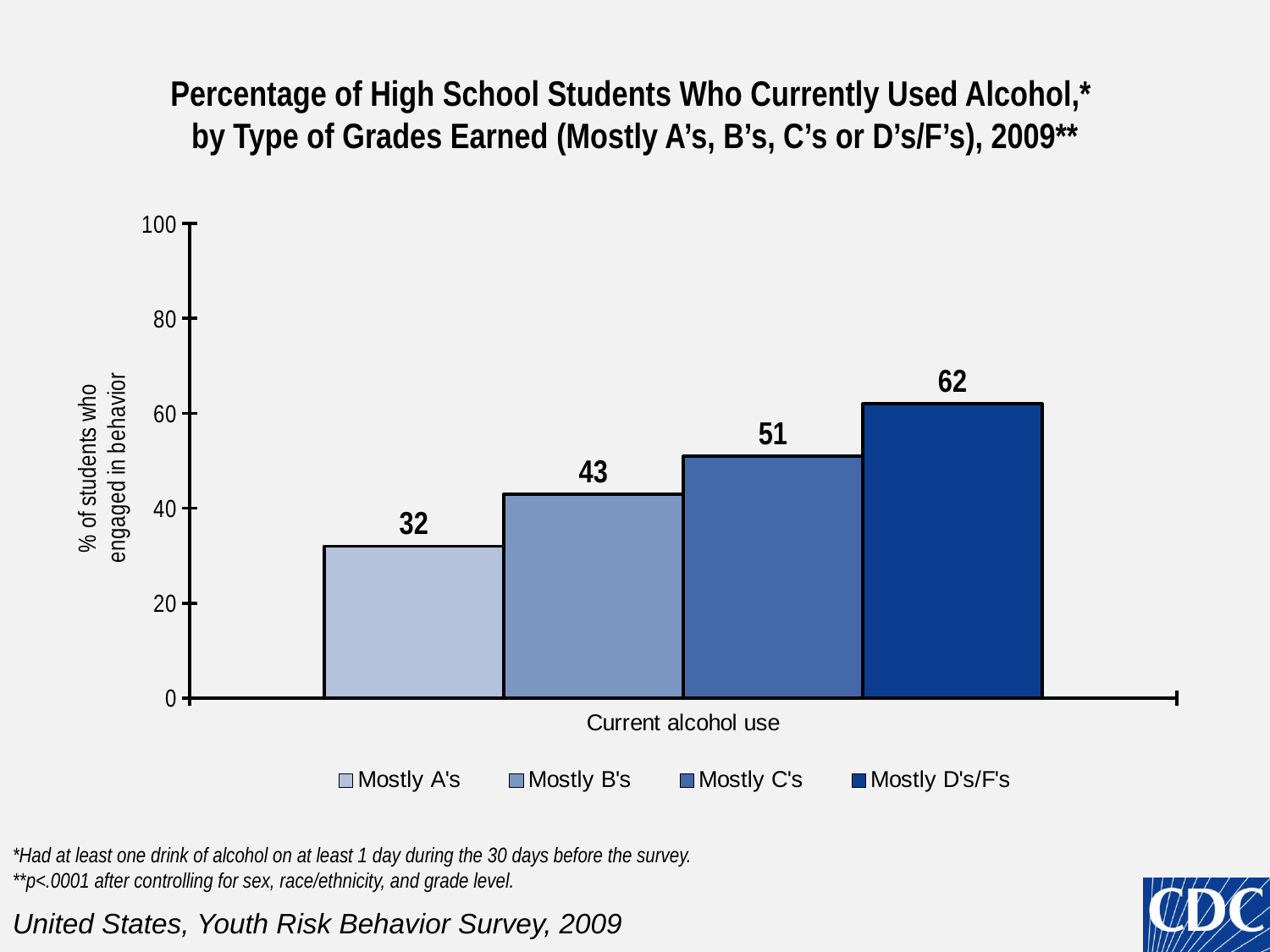
What is the difference between the values for Mostly C's and Mostly B's? 8 What percentage of students with Mostly A's currently used alcohol? 32 How many series does the legend list? 4 Which grade group has the lowest percentage of current alcohol use? Mostly A's What is the difference between the values for Mostly D's/F's and Mostly A's? 30 What is the value shown for Mostly C's? 51 What is the value shown for Mostly D's/F's? 62 Do the values rise or fall moving from Mostly A's to Mostly D's/F's? Rise Which grade group has the highest percentage of current alcohol use? Mostly D's/F's Is the value for Mostly B's greater or less than 40? greater Which is larger, the value for Mostly B's or the value for Mostly C's? Mostly C's What kind of chart is shown on the slide? Bar chart